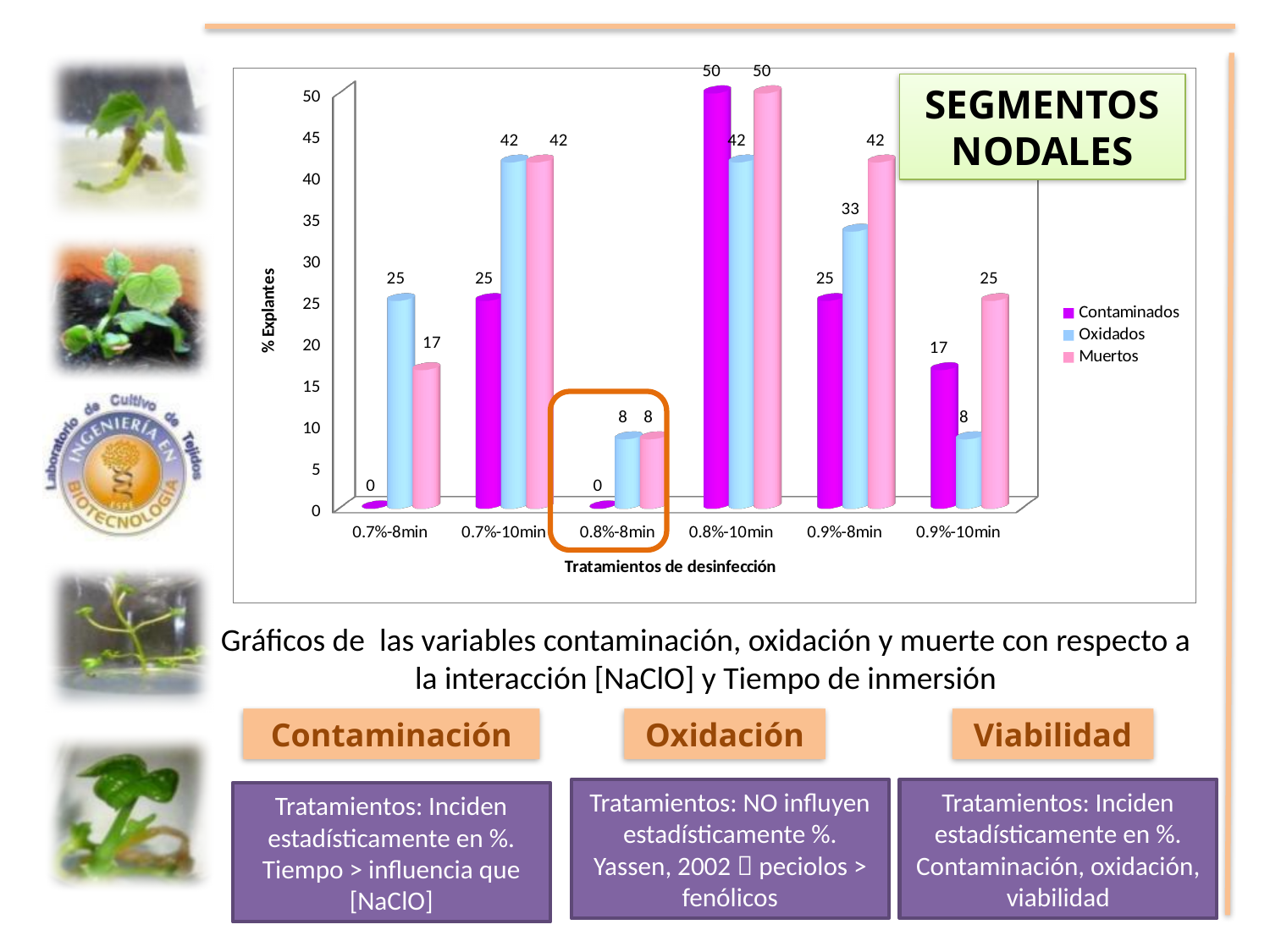
Which treatment has the highest Contaminados value? 0.8%-10min How many treatment categories are shown on the x axis? 6 What kind of chart is shown on the slide? Bar chart What is the Oxidados value for the 0.9%-8min treatment? 33 Which series is shown in magenta in the legend? Contaminados What is the Contaminados value for the 0.8%-10min treatment? 50 Which is larger: the Oxidados value for 0.7%-10min or the Oxidados value for 0.9%-8min? 0.7%-10min What is the Muertos value for the 0.7%-8min treatment? 17 Which treatment has the lowest Muertos value? 0.8%-8min How many series does the legend list? 3 What is the label of the y axis? % Explantes What is the difference between the Muertos values for 0.9%-8min and 0.9%-10min? 17